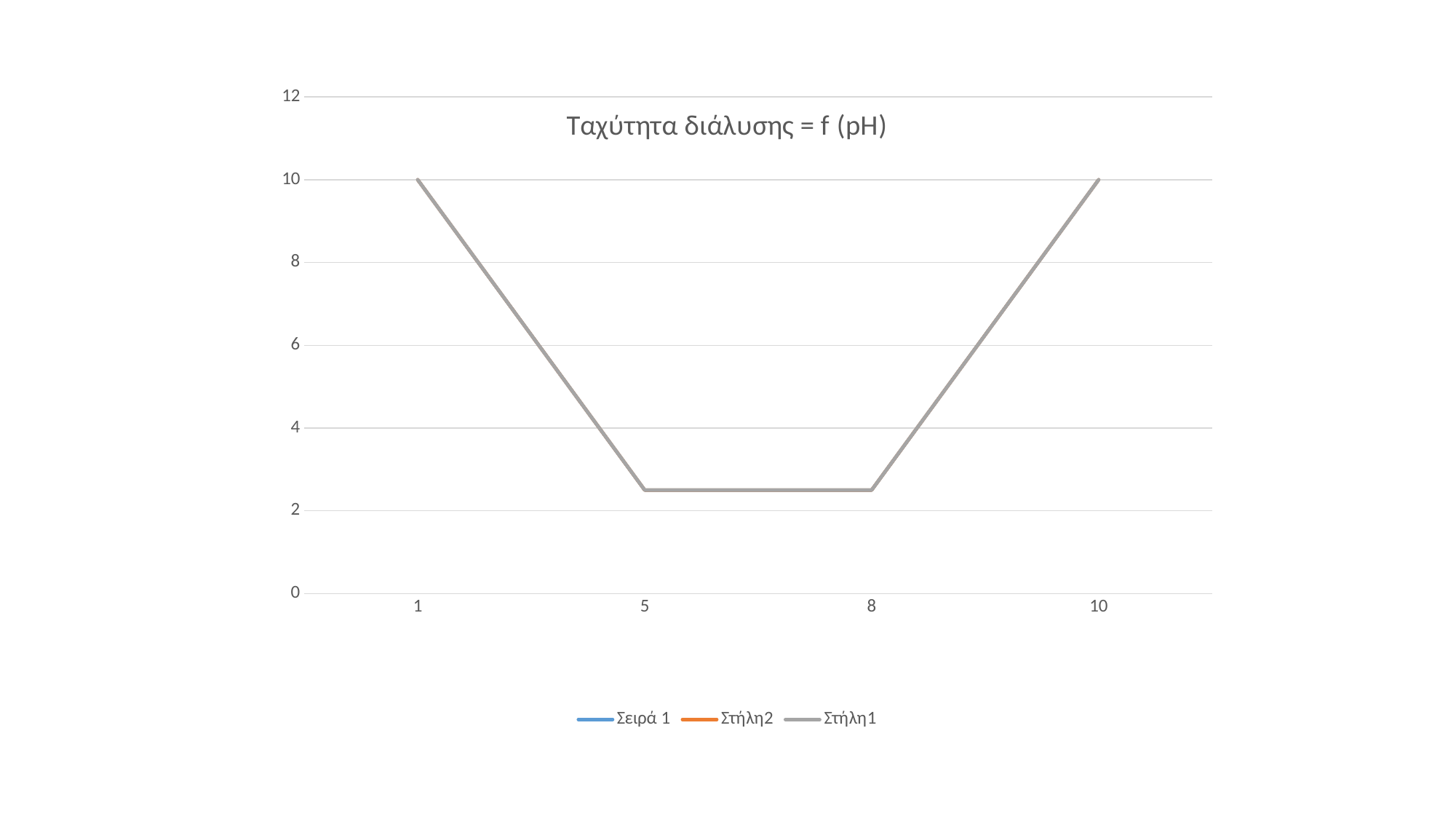
How many points are plotted along the x axis? 4 What is the value at x = 10? 10 Which has the larger value, x = 1 or x = 5? 1 How many series does the legend list? 3 Does the line rise or fall from x = 1 to x = 5? fall What is the title of the chart? Ταχύτητα διάλυσης = f (pH) Is the value at x = 8 greater or less than 4? less What is the value at x = 1? 10 Which has the larger value, x = 8 or x = 10? 10 What kind of chart is shown on the slide? line chart Is the value at x = 5 greater or less than 2? greater Which legend entries are listed below the chart? Σειρά 1, Στήλη2, Στήλη1